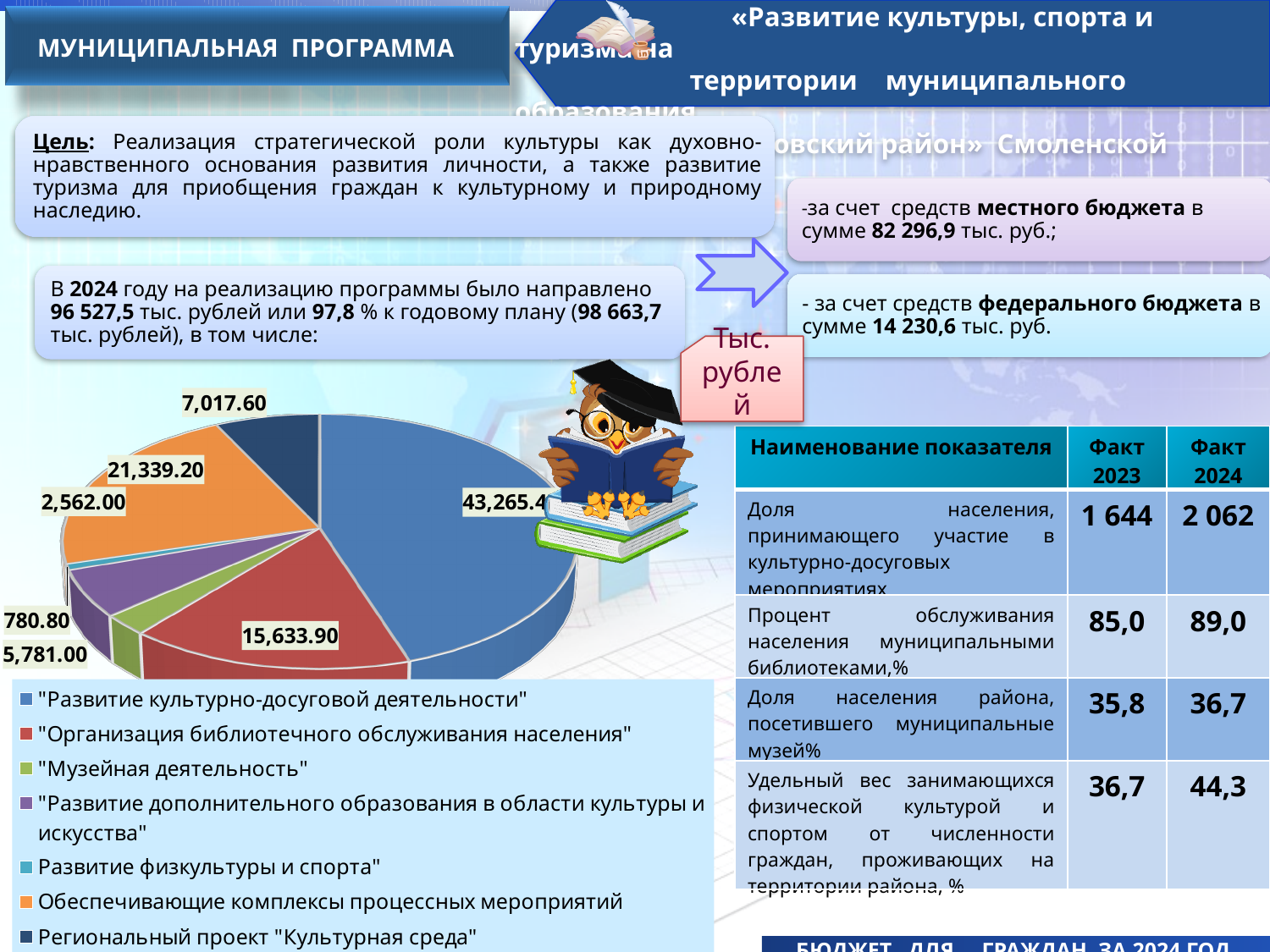
In what units are the pie chart values given, according to the label next to the chart? Тыс. рублей What is the difference between the values for "Обеспечивающие комплексы процессных мероприятий" and "Организация библиотечного обслуживания населения" in the pie chart? 5,705.30 Which is larger in the pie chart: "Организация библиотечного обслуживания населения" or "Обеспечивающие комплексы процессных мероприятий"? "Обеспечивающие комплексы процессных мероприятий" What colour represents "Музейная деятельность" in the pie chart legend? green How many categories does the pie chart's legend list? 7 What is the value for "Обеспечивающие комплексы процессных мероприятий" in the pie chart? 21,339.20 What is the value for Региональный проект "Культурная среда" in the pie chart? 7,017.60 Which category has the largest slice in the pie chart? "Развитие культурно-досуговой деятельности" What kind of chart is shown on the slide? pie chart What is the difference between the values for "Организация библиотечного обслуживания населения" and Региональный проект "Культурная среда" in the pie chart? 8,616.30 Which is larger in the pie chart: Региональный проект "Культурная среда" or "Организация библиотечного обслуживания населения"? "Организация библиотечного обслуживания населения" What is the value for "Организация библиотечного обслуживания населения" in the pie chart? 15,633.90